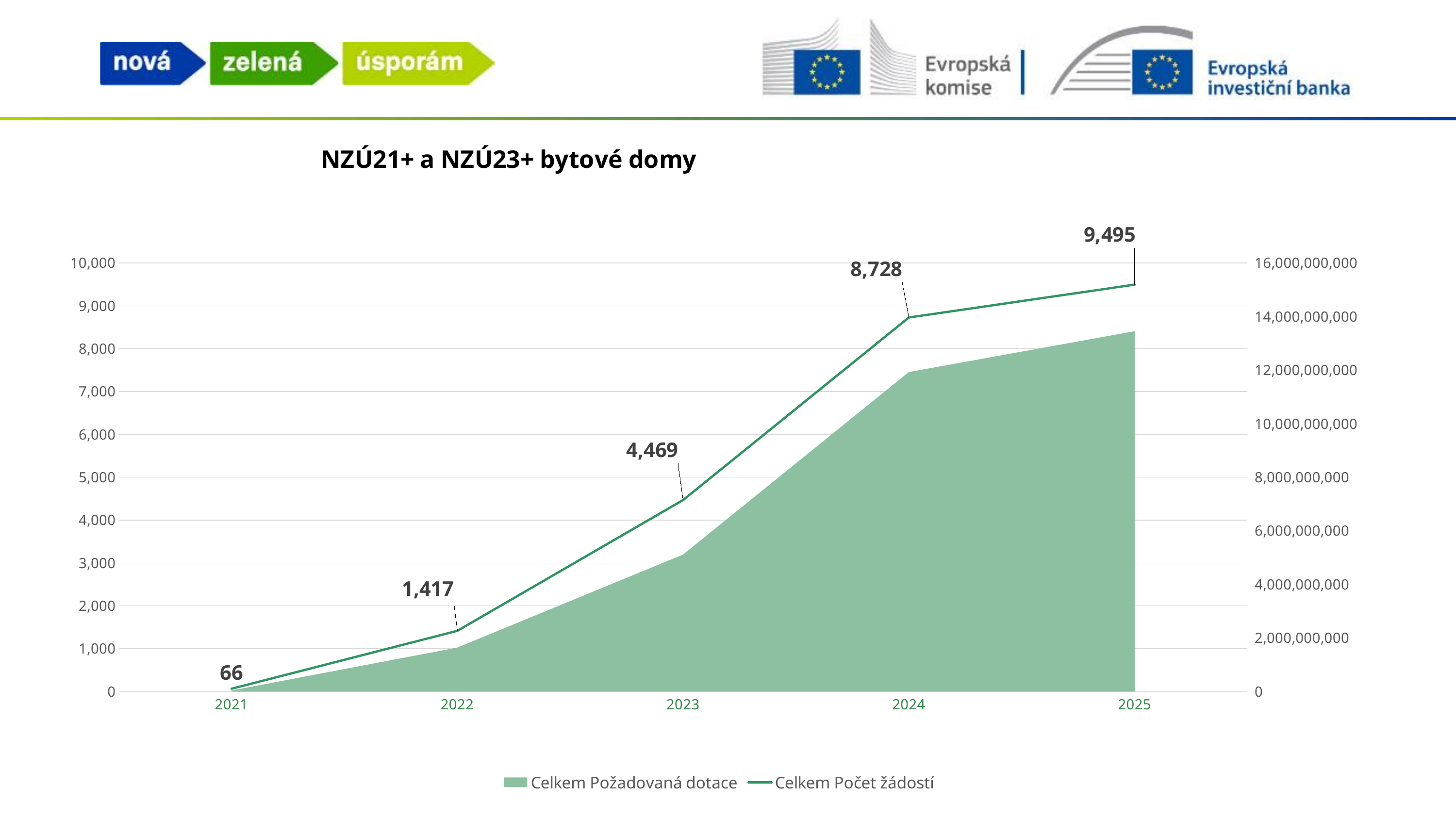
Is the value of Celkem Požadovaná dotace in 2025 greater or less than 12,000,000,000? greater What is the value of Celkem Počet žádostí in 2025? 9,495 How many series does the legend list? 2 Which year has a larger Celkem Počet žádostí, 2022 or 2023? 2023 What is the value of Celkem Počet žádostí in 2021? 66 Does Celkem Počet žádostí rise or fall from 2021 to 2025? rise In which year is Celkem Počet žádostí lowest? 2021 What is the value of Celkem Počet žádostí in 2023? 4,469 Is the value of Celkem Požadovaná dotace in 2022 greater or less than 4,000,000,000? less In which year is Celkem Počet žádostí highest? 2025 How many years are shown on the x axis? 5 What is the difference in Celkem Počet žádostí between 2024 and 2023? 4,259